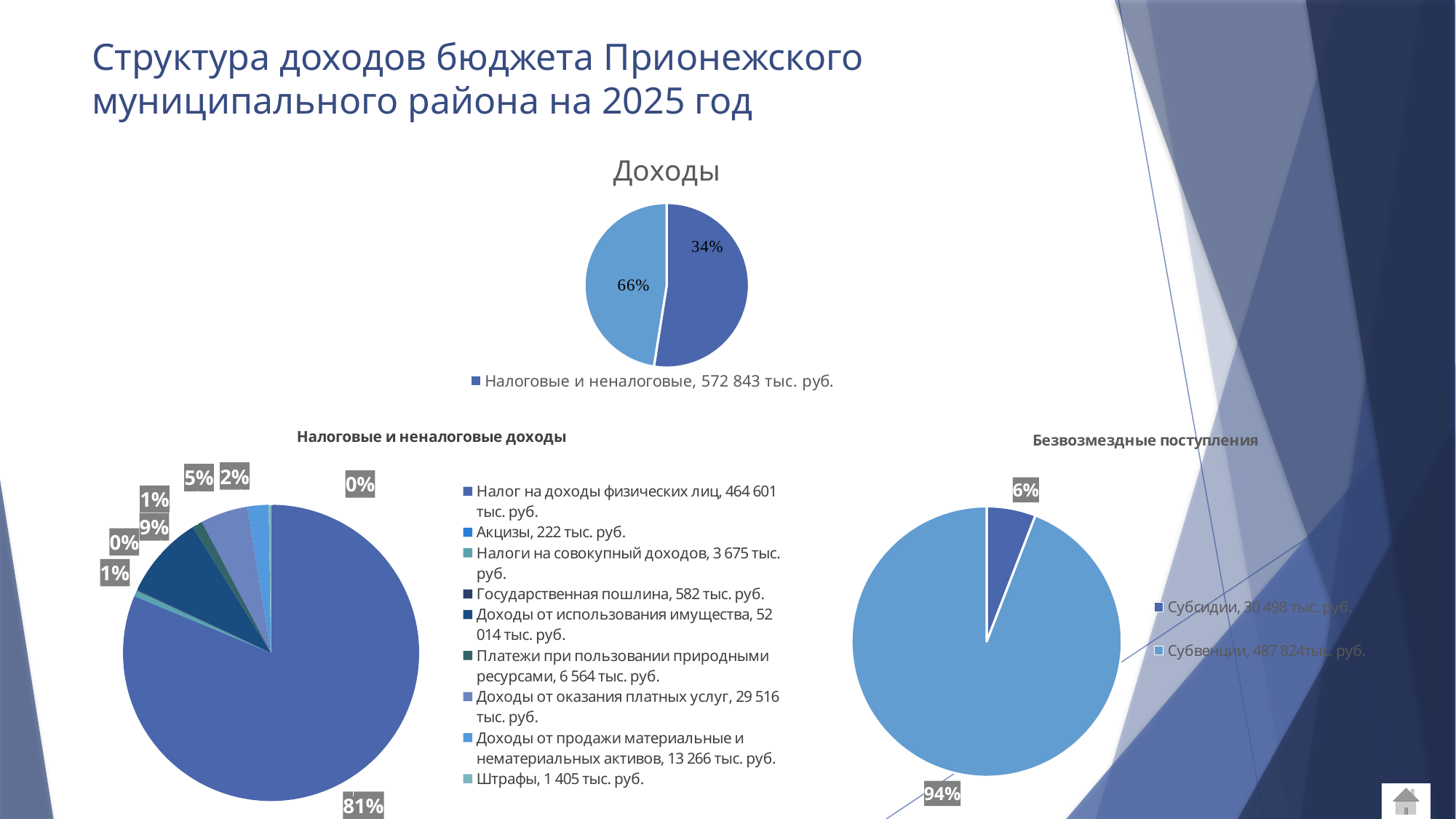
In the "Доходы" pie chart, what share is labelled on the larger slice? 66% In the "Налоговые и неналоговые доходы" pie chart, which category has the largest slice? Налог на доходы физических лиц What kind of chart is the "Доходы" chart at the top of the slide? pie chart In the "Безвозмездные поступления" pie chart, what share does "Субсидии" have? 6% In the "Безвозмездные поступления" chart, what value does the legend give for "Субсидии"? 30 498 тыс. руб. In the "Налоговые и неналоговые доходы" pie chart, what share is labelled on the largest slice? 81% In the "Налоговые и неналоговые доходы" chart, what value does the legend give for "Доходы от использования имущества"? 52 014 тыс. руб. In the "Налоговые и неналоговые доходы" chart, which is larger: "Доходы от оказания платных услуг" or "Доходы от продажи материальные и нематериальных активов"? Доходы от оказания платных услуг What is the title of the pie chart at the bottom right of the slide? Безвозмездные поступления How many categories does the legend of the "Налоговые и неналоговые доходы" chart list? 9